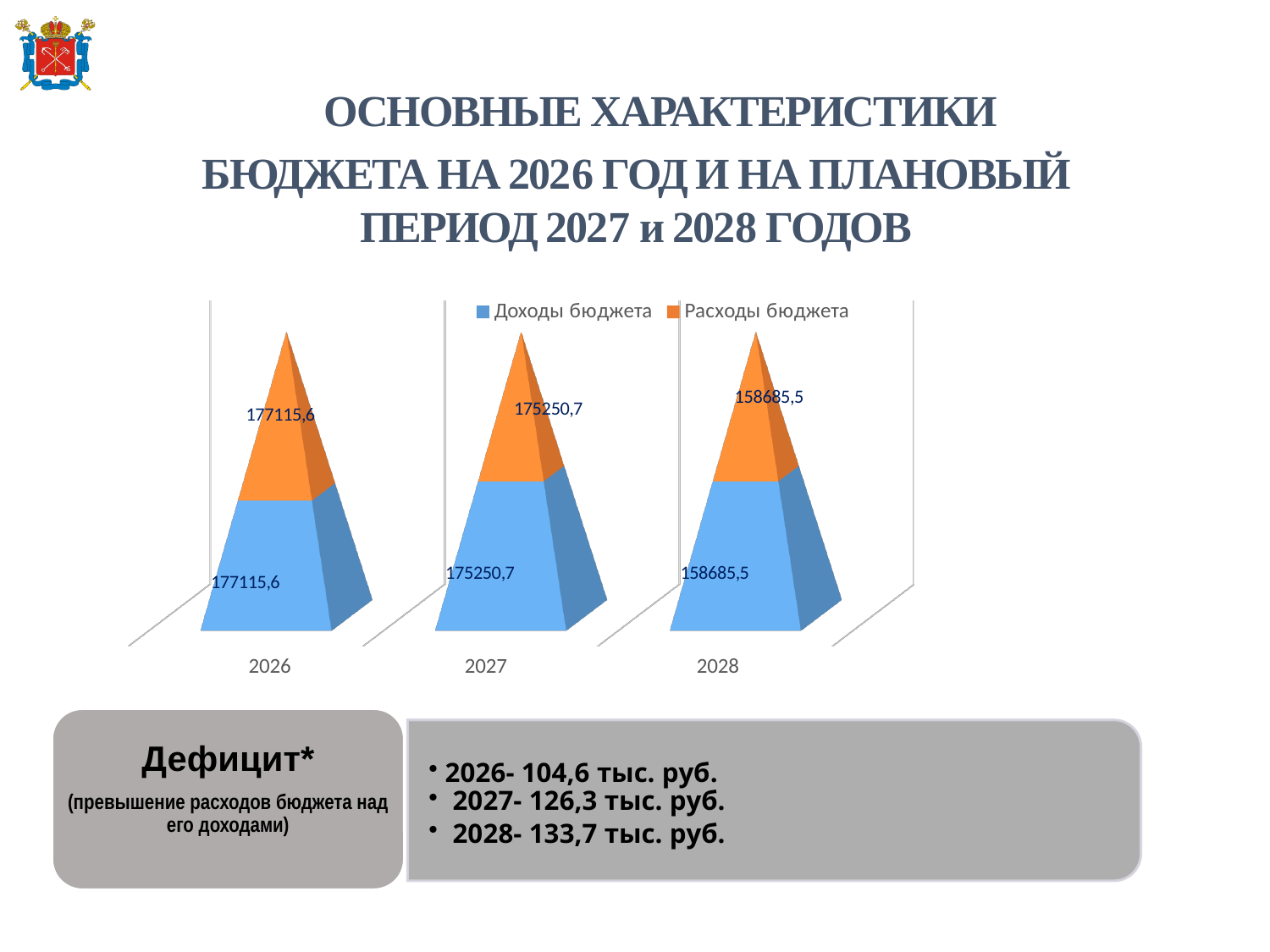
Do the Доходы бюджета values rise or fall from 2026 to 2028? Fall What is the value of Доходы бюджета for 2026? 177115,6 How many years are shown on the x axis of the chart? 3 Which year has the highest value for Доходы бюджета? 2026 Is the Доходы бюджета value larger for 2026 or for 2028? 2026 Which year has the lowest value for Расходы бюджета? 2028 What is the value of Доходы бюджета for 2028? 158685,5 What is the difference between the Расходы бюджета values for 2027 and 2028? 16565,2 How many series does the chart legend list? 2 What is the value of Расходы бюджета for 2027? 175250,7 What kind of chart is shown on the slide? Bar chart What is the difference between the Доходы бюджета values for 2026 and 2027? 1864,9